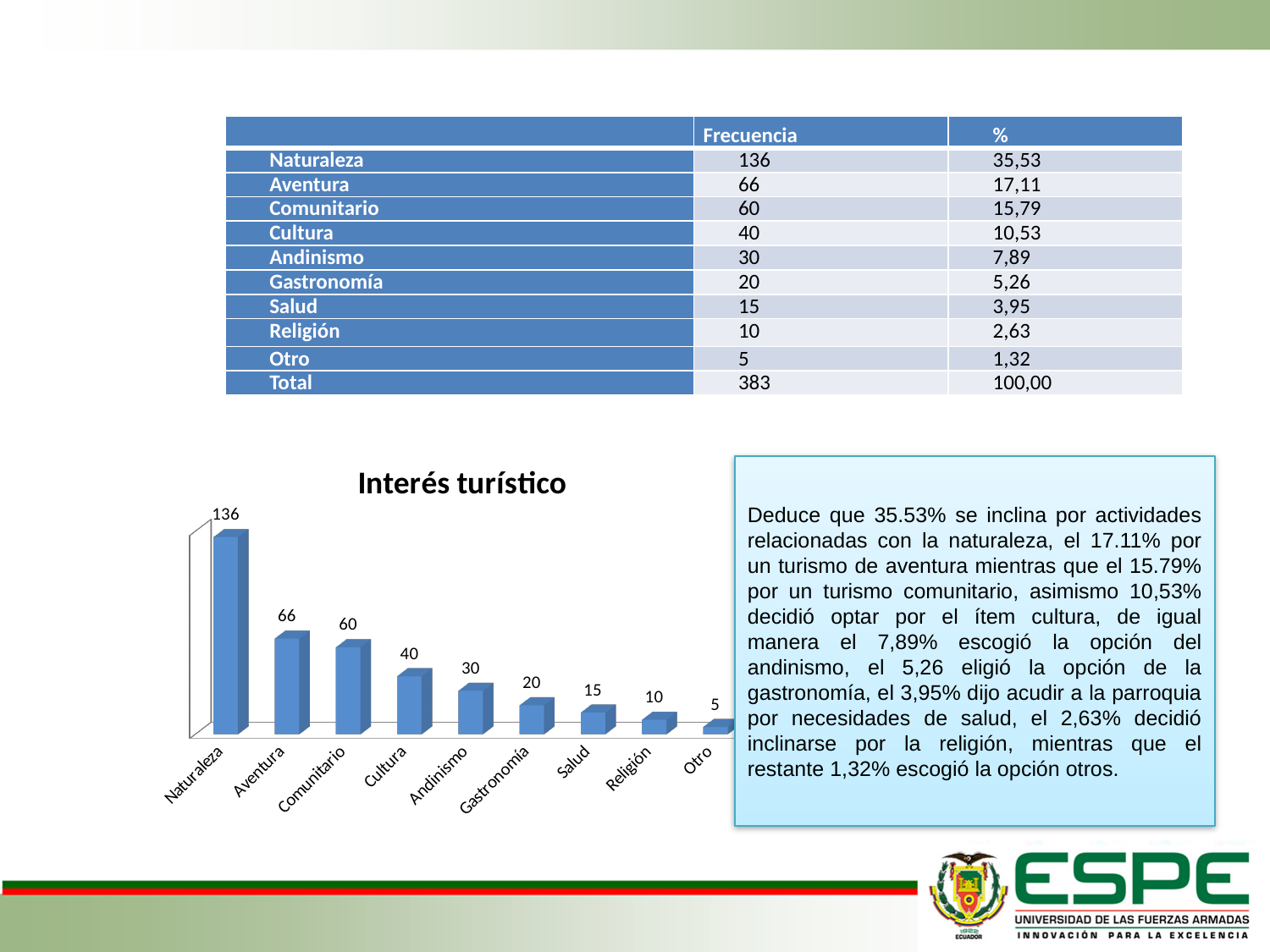
How many categories are shown on the x axis of the chart? 9 Do the values rise or fall from left to right along the x axis? fall What type of chart is shown on the slide? bar chart What is the value for Andinismo in the chart? 30 What is the title of the chart? Interés turístico What is the difference between the values for Naturaleza and Aventura? 70 Which is larger, the value for Cultura or the value for Gastronomía? Cultura What is the difference between the values for Salud and Religión? 5 Which category has the lowest value in the chart? Otro What is the value for Naturaleza in the chart? 136 What is the value for Comunitario in the chart? 60 Which category has the highest value in the chart? Naturaleza